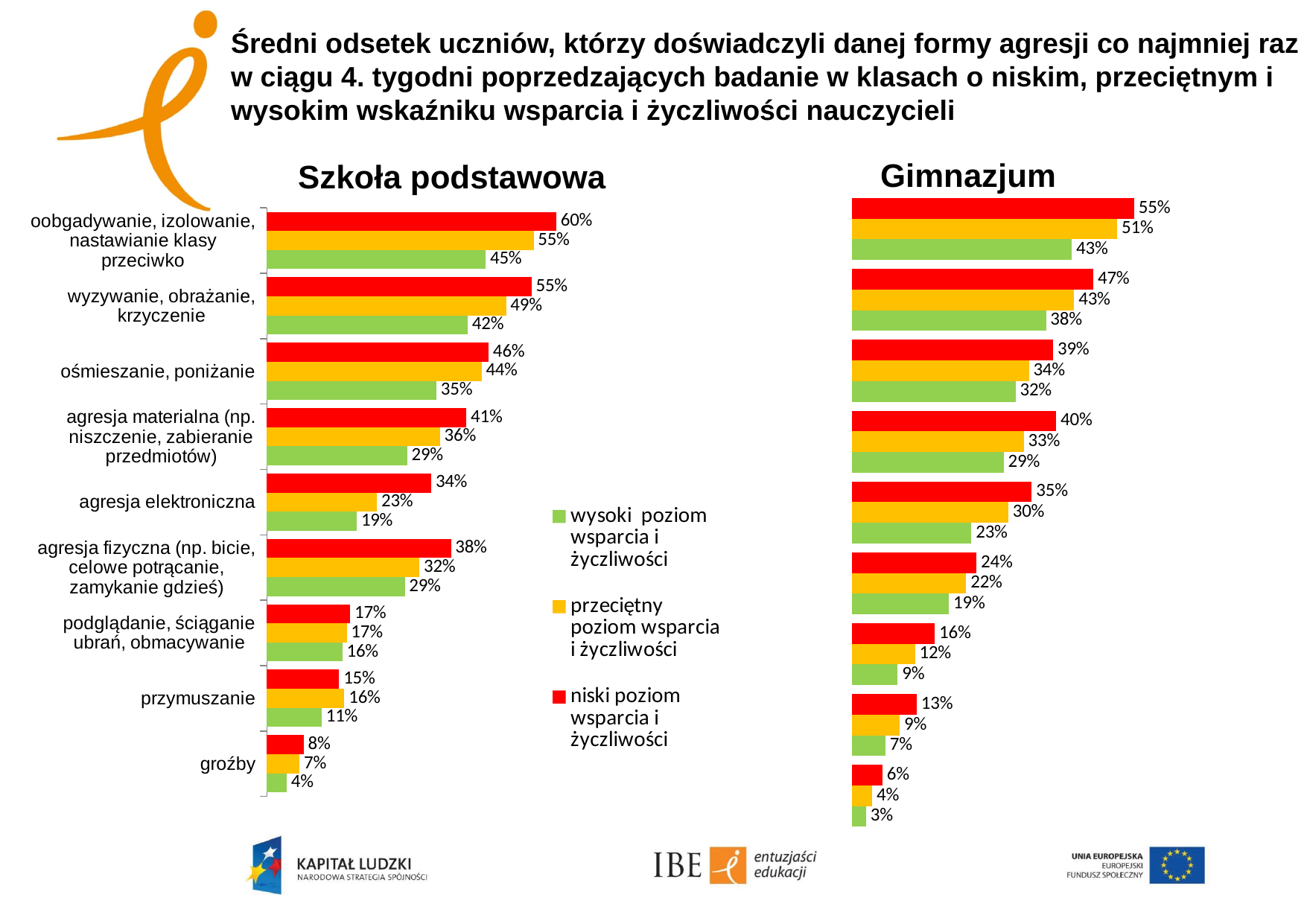
In the Szkoła podstawowa chart, what is the value for 'agresja elektroniczna' in the 'wysoki poziom wsparcia i życzliwości' series? 19% In the Szkoła podstawowa chart, for 'przymuszanie', which is larger: the 'niski poziom' value or the 'przeciętny poziom' value? przeciętny poziom (16%) In the Szkoła podstawowa chart, which category has the highest value in the 'przeciętny poziom wsparcia i życzliwości' series? oobgadywanie, izolowanie, nastawianie klasy przeciwko What type of chart is used for Szkoła podstawowa and Gimnazjum? Bar chart In the Szkoła podstawowa chart, what is the difference between the 'niski' and 'wysoki' values for 'ośmieszanie, poniżanie'? 11 percentage points How many categories (forms of aggression) are listed in the Szkoła podstawowa chart? 9 How many series does the legend list? 3 In the Gimnazjum chart, what is the value of the top (first) red bar, for 'niski poziom wsparcia i życzliwości'? 55% In the Szkoła podstawowa chart, which category has the lowest value in the 'wysoki poziom wsparcia i życzliwości' series? groźby In the Gimnazjum chart, what is the difference between the red and green bars in the first (top) row? 12 percentage points In the Gimnazjum chart, what is the value of the bottom (last) green bar, for 'wysoki poziom wsparcia i życzliwości'? 3% In the Szkoła podstawowa chart, what is the value for 'oobgadywanie, izolowanie, nastawianie klasy przeciwko' in the 'niski poziom wsparcia i życzliwości' series? 60%